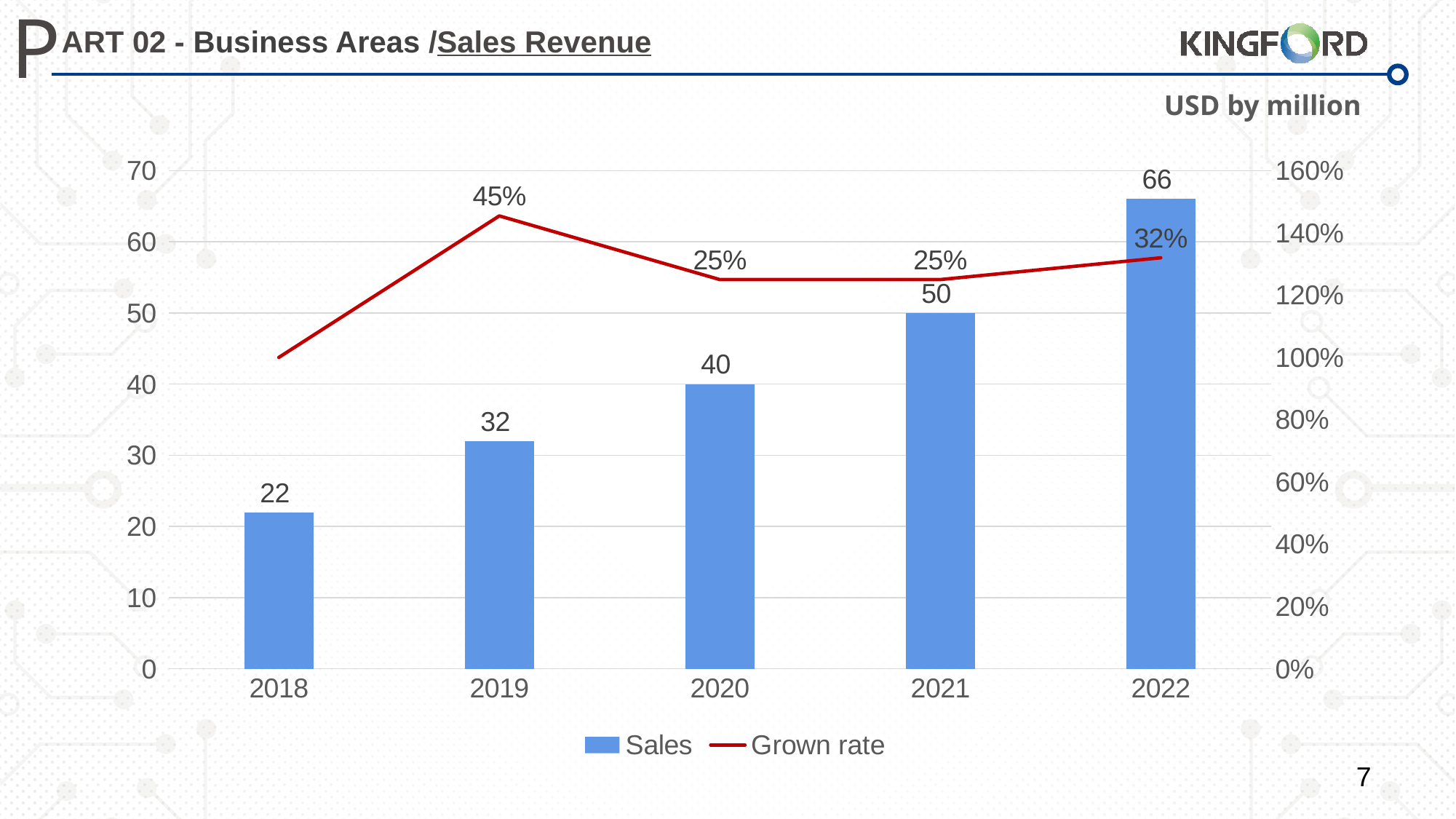
How many series does the legend list? 2 What is the difference in Sales between 2022 and 2021? 16 Which year has the highest Sales? 2022 What is the Grown rate for 2019? 45% Is the Grown rate for 2018 greater or less than 80%? greater Which is larger, the Sales value for 2019 or for 2020? 2020 Do the Sales values rise or fall from 2018 to 2022? rise What unit is stated above the chart? USD by million What is the Sales value for 2020? 40 Which year has the lowest Sales? 2018 What is the Sales value for 2022? 66 How many years are shown on the x axis? 5